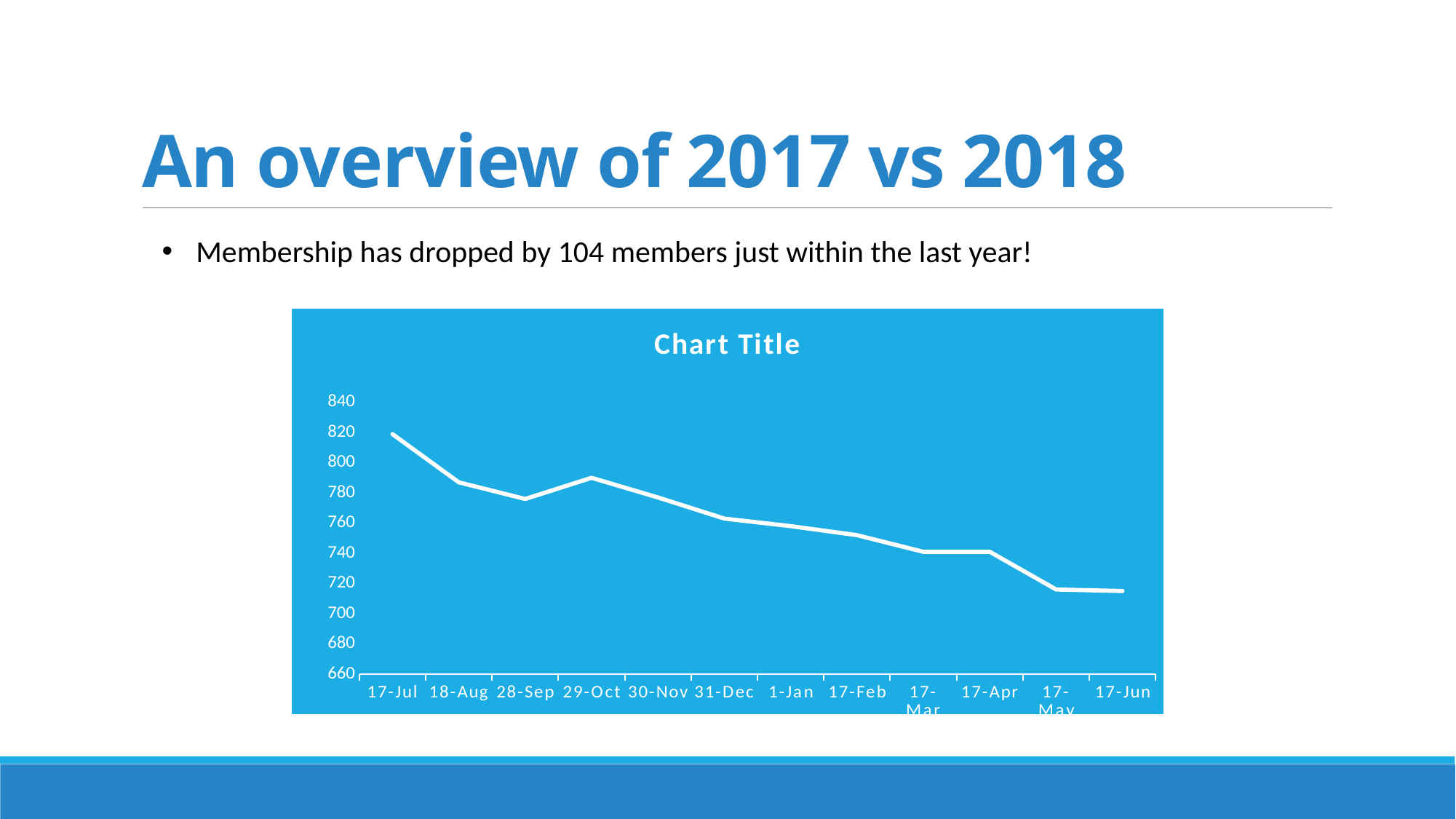
What kind of chart is shown on the slide? line chart Which date has the highest value on the chart? 17-Jul How many data points are plotted along the x axis of the chart? 12 Is the value for 17-Feb greater or less than 760? less What is the title of the chart? Chart Title Is the value for 29-Oct greater or less than 780? greater Is the value for 17-Jul greater or less than 800? greater Do the values on the chart generally rise or fall from 17-Jul to 17-Jun? fall Which has the larger value, 17-Jul or 17-Jun? 17-Jul Which has the larger value, 29-Oct or 28-Sep? 29-Oct